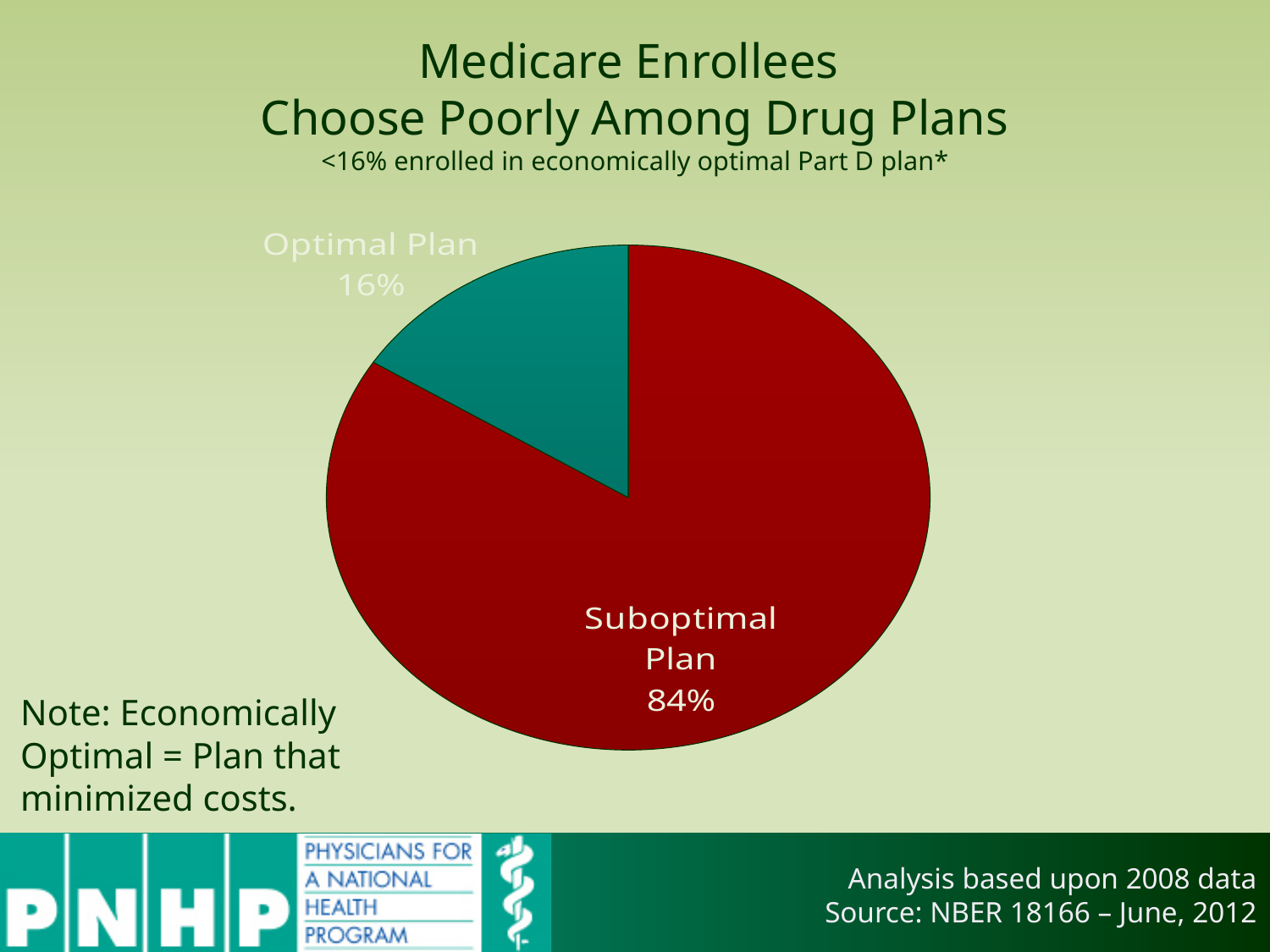
Which is larger, the Optimal Plan slice or the Suboptimal Plan slice? Suboptimal Plan What share of the pie is labelled Suboptimal Plan? 84% How many slices does the pie chart have? 2 What is the difference in percentage points between the Suboptimal Plan slice and the Optimal Plan slice? 68 What is the total of the two slices shown in the pie chart? 100% What colour is the Suboptimal Plan slice? dark red Which slice of the pie is the smallest? Optimal Plan What kind of chart is shown on the slide? pie chart What colour is the Optimal Plan slice? teal Which slice of the pie is the largest? Suboptimal Plan What share of the pie is labelled Optimal Plan? 16%